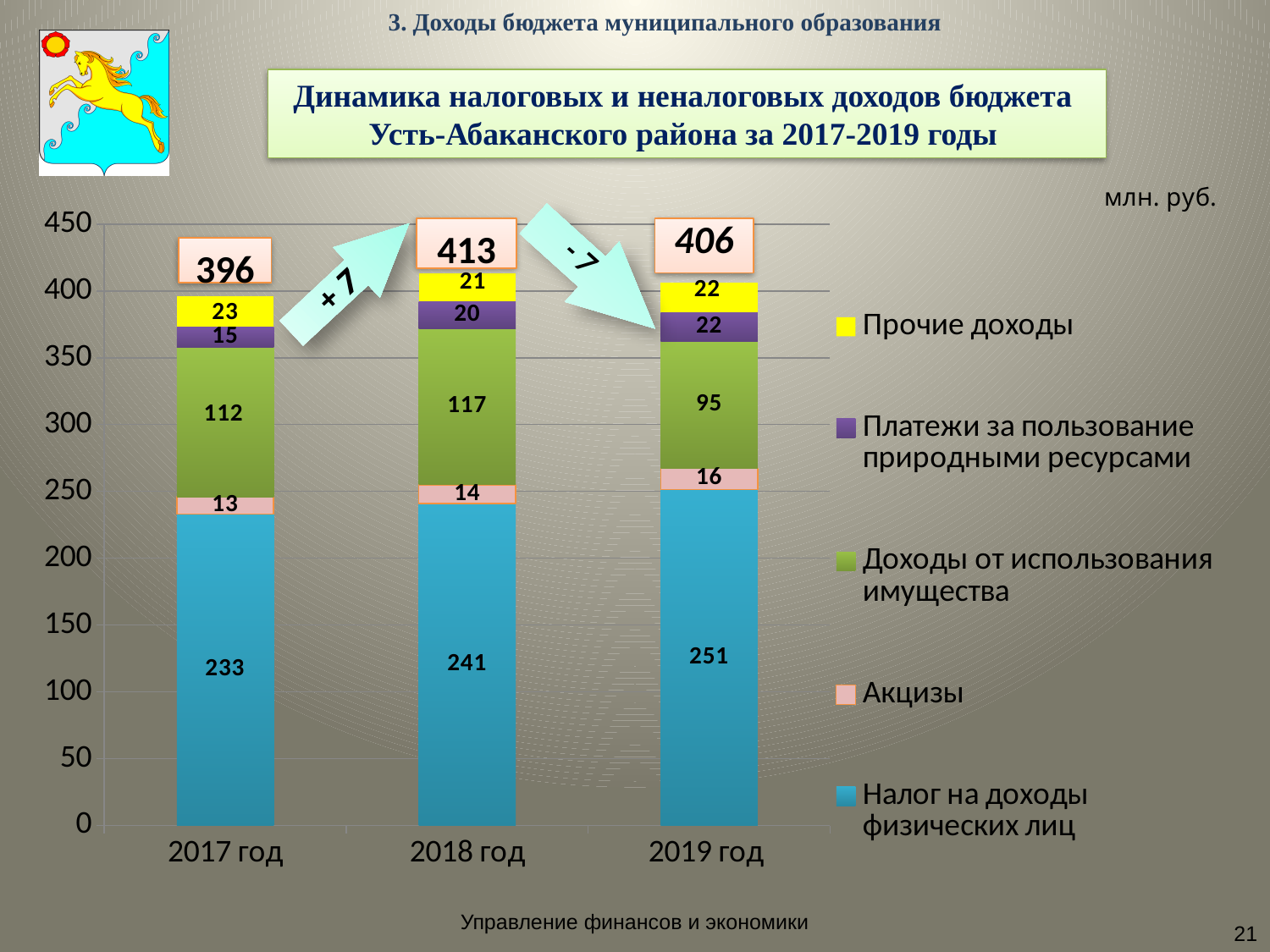
What is the difference between the Доходы от использования имущества values for 2018 год and 2019 год? 22 What is the value for Доходы от использования имущества in 2019 год? 95 What is the total of the stacked bar for 2018 год? 413 Which is larger: Прочие доходы in 2017 год or Прочие доходы in 2018 год? 2017 год What kind of chart is shown on the slide? Stacked bar chart Which year has the highest total of the stacked bar? 2018 год Does the value for Налог на доходы физических лиц rise or fall from 2017 год to 2019 год? Rise How many years are shown on the x axis? 3 How many series does the legend list? 5 What is the value for Акцизы in 2018 год? 14 Which year has the lowest value for Налог на доходы физических лиц? 2017 год What is the value for Налог на доходы физических лиц in 2017 год? 233